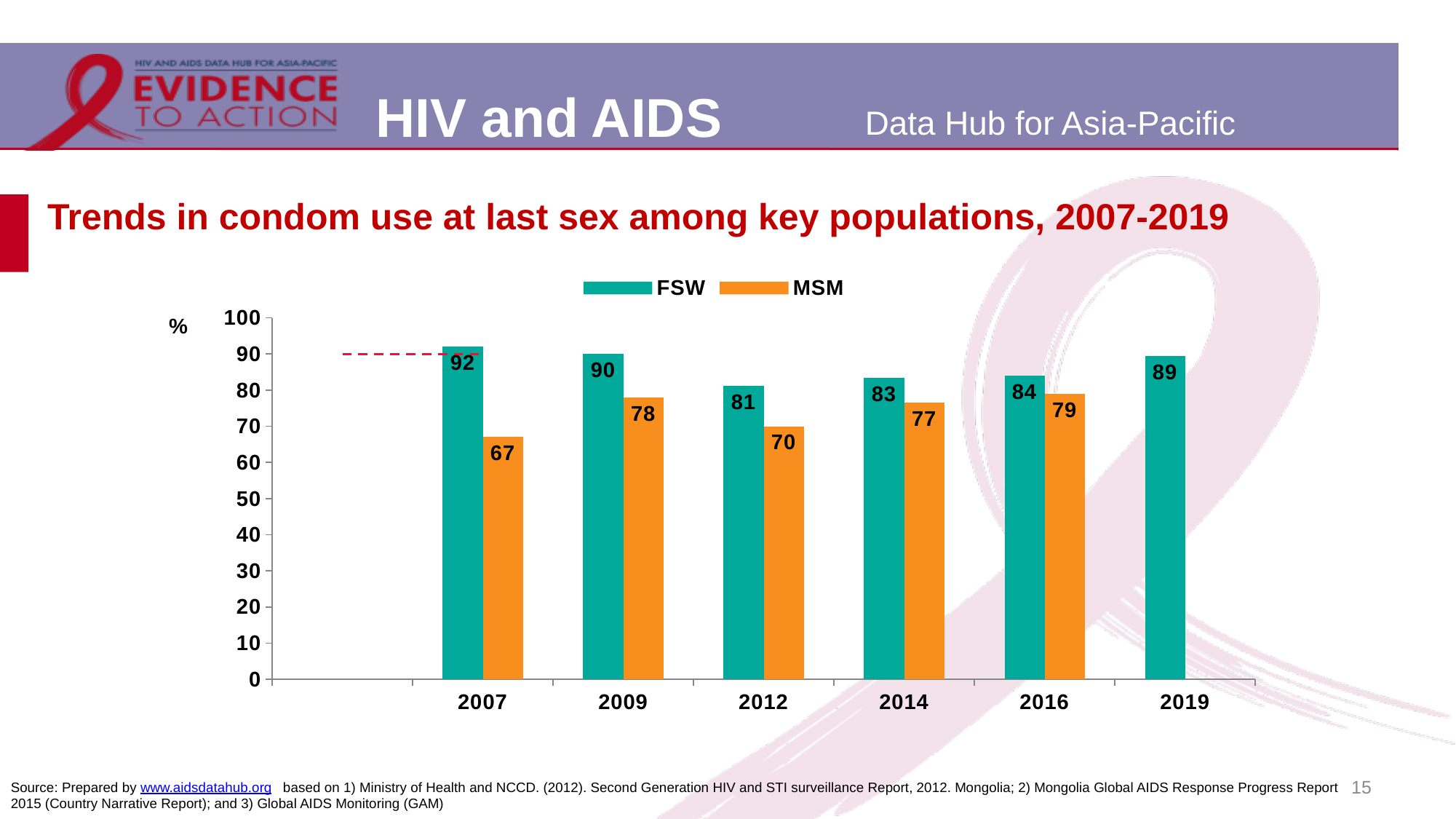
What is the FSW value for 2019? 89 What is the difference between the FSW and MSM values in 2007? 25 How many years are shown on the x axis? 6 What is the FSW value for 2007? 92 Which is larger in 2016, the FSW value or the MSM value? FSW Do the MSM values rise or fall from 2007 to 2016? Rise How many series does the legend list? 2 What kind of chart is shown on the slide? Bar chart Which colour represents the MSM series? Orange What is the MSM value for 2012? 70 In which year is the FSW value highest? 2007 In which year is the MSM value lowest? 2007